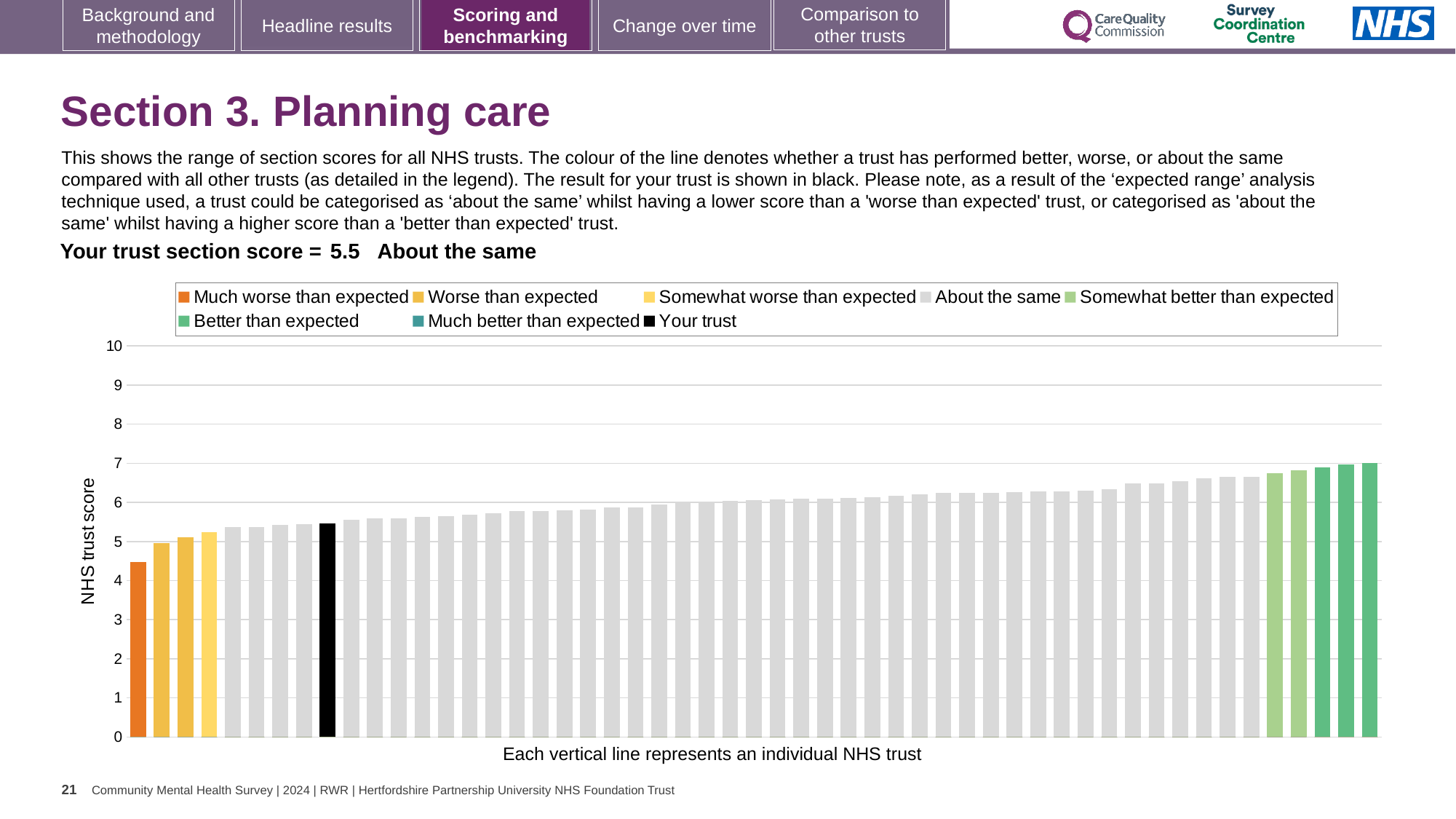
Is the value of the rightmost bar greater or less than 6? greater What is the label on the vertical axis of the chart? NHS trust score What kind of chart is shown on the slide? bar chart Is the value of the black 'Your trust' bar greater or less than 5? greater How many entries does the chart legend list? 8 What does each vertical line in the chart represent, according to the axis label? An individual NHS trust How many bars are coloured orange (Much worse than expected)? 1 What is the highest value shown on the vertical axis? 10 Is the value of the leftmost (orange) bar greater or less than 5? less Which category is the trust's section score placed in? About the same Do the bar values rise or fall from left to right along the x axis? rise What is the trust's section score shown on the slide? 5.5